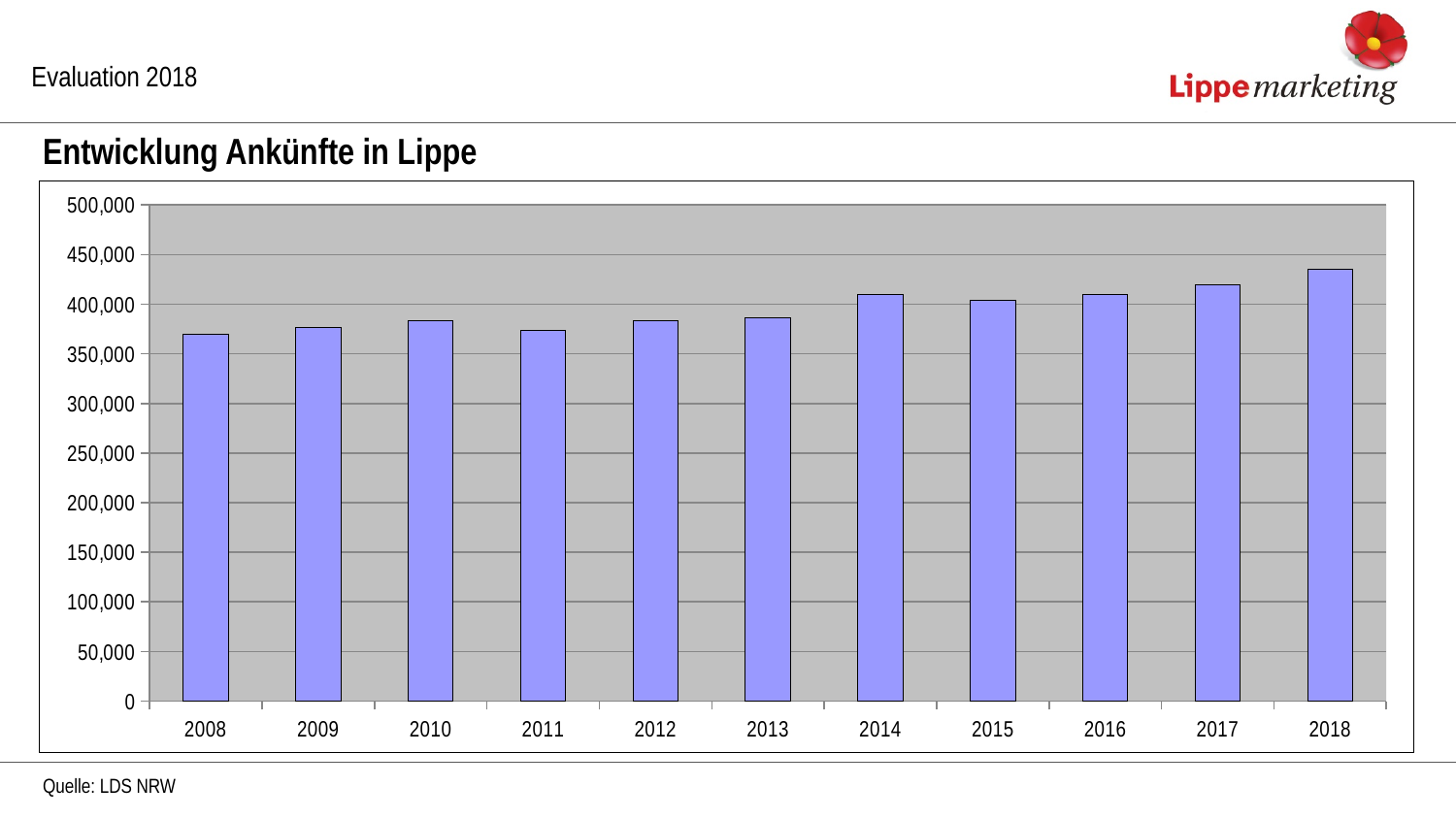
Which is larger, the value for 2013 or the value for 2014? 2014 How many years are shown on the x axis of the chart? 11 Is the value for 2018 greater or less than 400,000? greater Which is larger, the value for 2008 or the value for 2018? 2018 What is the title of the chart? Entwicklung Ankünfte in Lippe Is the value for 2017 greater or less than 400,000? greater What type of chart is shown on the slide? bar chart Do the values generally rise or fall from 2008 to 2018? rise Is the value for 2018 greater or less than 450,000? less Which year has the highest value in the chart? 2018